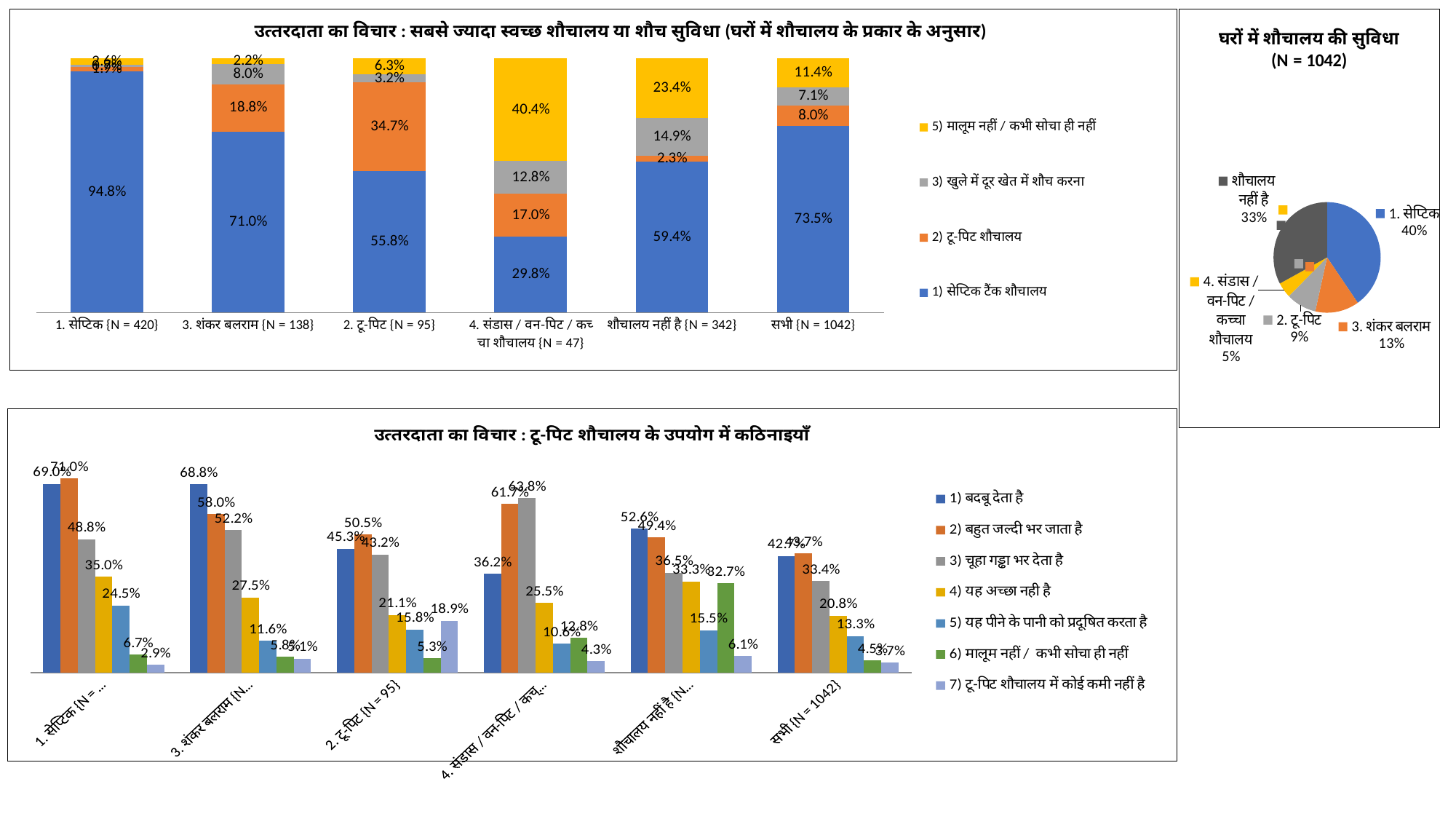
In the top stacked bar chart, what is the value of the '5) मालूम नहीं / कभी सोचा ही नहीं' series for the '4. संडास / वन-पिट / कच्चा शौचालय {N = 47}' category? 40.4% How many slices does the pie chart 'घरों में शौचालय की सुविधा (N = 1042)' have? 5 In the top stacked bar chart, what is the value of the '2) टू-पिट शौचालय' series for the '2. टू-पिट {N = 95}' category? 34.7% In the bottom bar chart 'टू-पिट शौचालय के उपयोग में कठिनाइयाँ', what is the value of the '3) चूहा गड्ढा भर देता है' series for the '4. संडास / वन-पिट / कच्चा...' category? 63.8% In the top stacked bar chart, what is the difference between the '1) सेप्टिक टैंक शौचालय' values for '3. शंकर बलराम {N = 138}' and '2. टू-पिट {N = 95}'? 15.2% In the pie chart 'घरों में शौचालय की सुविधा (N = 1042)', which slice is the smallest? 4. संडास / वन-पिट / कच्चा शौचालय How many series does the legend of the top stacked bar chart list? 4 In the bottom bar chart 'टू-पिट शौचालय के उपयोग में कठिनाइयाँ', which is larger for the '2. टू-पिट {N = 95}' category: '1) बदबू देता है' or '2) बहुत जल्दी भर जाता है'? 2) बहुत जल्दी भर जाता है In the top stacked bar chart, what is the value of the '1) सेप्टिक टैंक शौचालय' series for the '1. सेप्टिक {N = 420}' category? 94.8% In the pie chart 'घरों में शौचालय की सुविधा (N = 1042)', what share does '1. सेप्टिक' have? 40% In the top stacked bar chart, which category has the lowest value for the '1) सेप्टिक टैंक शौचालय' series? 4. संडास / वन-पिट / कच्चा शौचालय {N = 47} How many series does the legend of the bottom bar chart 'टू-पिट शौचालय के उपयोग में कठिनाइयाँ' list? 7